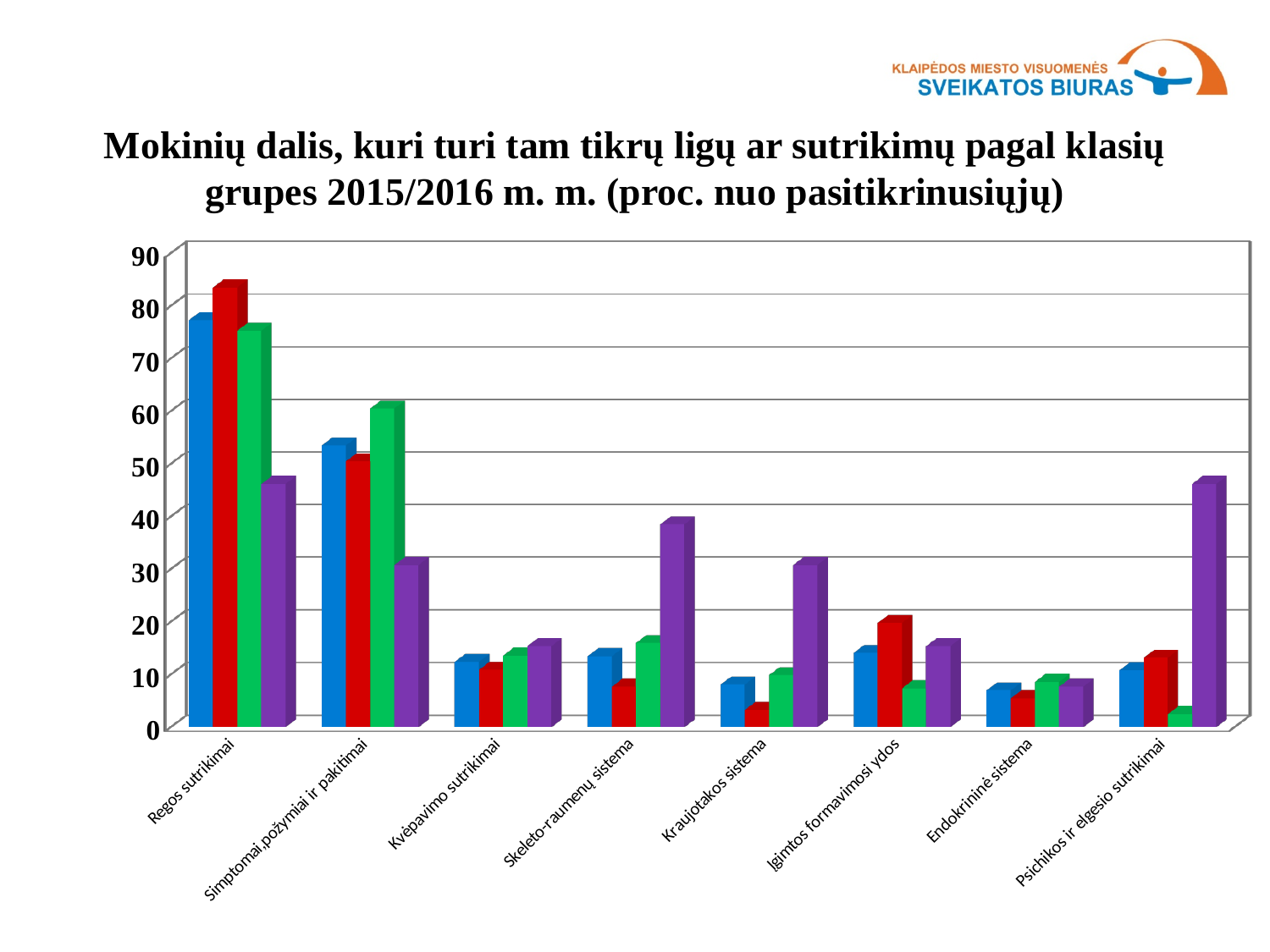
For Regos sutrikimai, which is larger: the blue bar or the purple bar? the blue bar How many categories are shown along the x axis of the chart? 8 Is the value of the blue bar for Endokrininė sistema greater or less than 10? less What kind of chart is shown on the slide? bar chart For Simptomai, požymiai ir pakitimai, which is larger: the green bar or the purple bar? the green bar For Psichikos ir elgesio sutrikimai, which is larger: the purple bar or the blue bar? the purple bar Is the value of the blue bar for Regos sutrikimai greater or less than 70? greater Is the value of the purple bar for Psichikos ir elgesio sutrikimai greater or less than 40? greater How many differently coloured bars are shown for each category in the chart? 4 Which category has the tallest bars in the chart? Regos sutrikimai